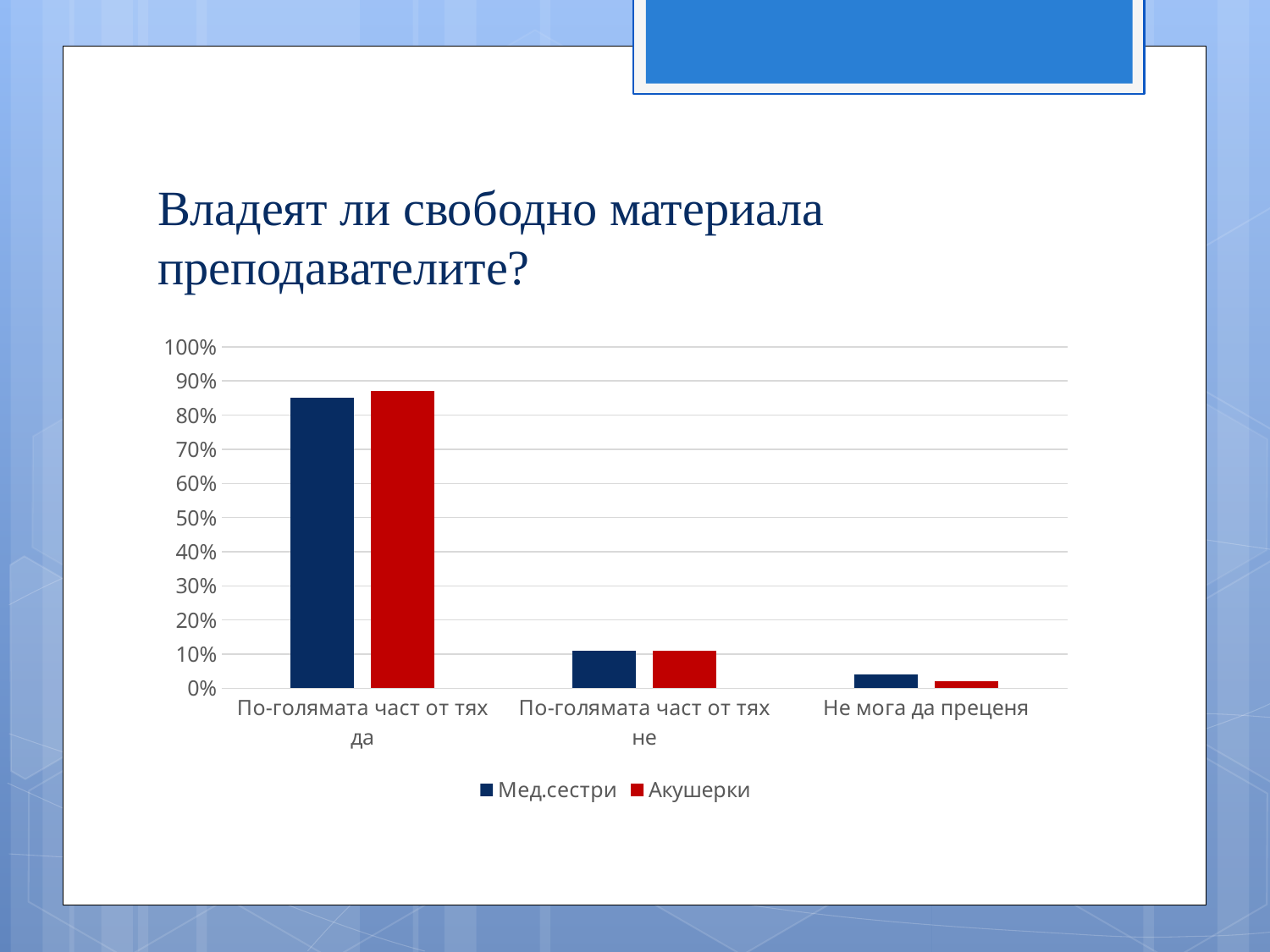
What is the title of the slide above the chart? Владеят ли свободно материала преподавателите? Which colour represents the Акушерки series in the legend? red Is the value for Акушерки in the category 'По-голямата част от тях да' greater or less than 90%? less Which category has the highest value for Акушерки? По-голямата част от тях да How many series does the legend list? 2 Is the value for Акушерки in the category 'Не мога да преценя' greater or less than 10%? less Is the value for Мед.сестри in the category 'По-голямата част от тях да' greater or less than 80%? greater Which category has the lowest value for Акушерки? Не мога да преценя What kind of chart is shown on the slide? bar chart How many categories are shown on the x axis? 3 Which category has the highest value for Мед.сестри? По-голямата част от тях да